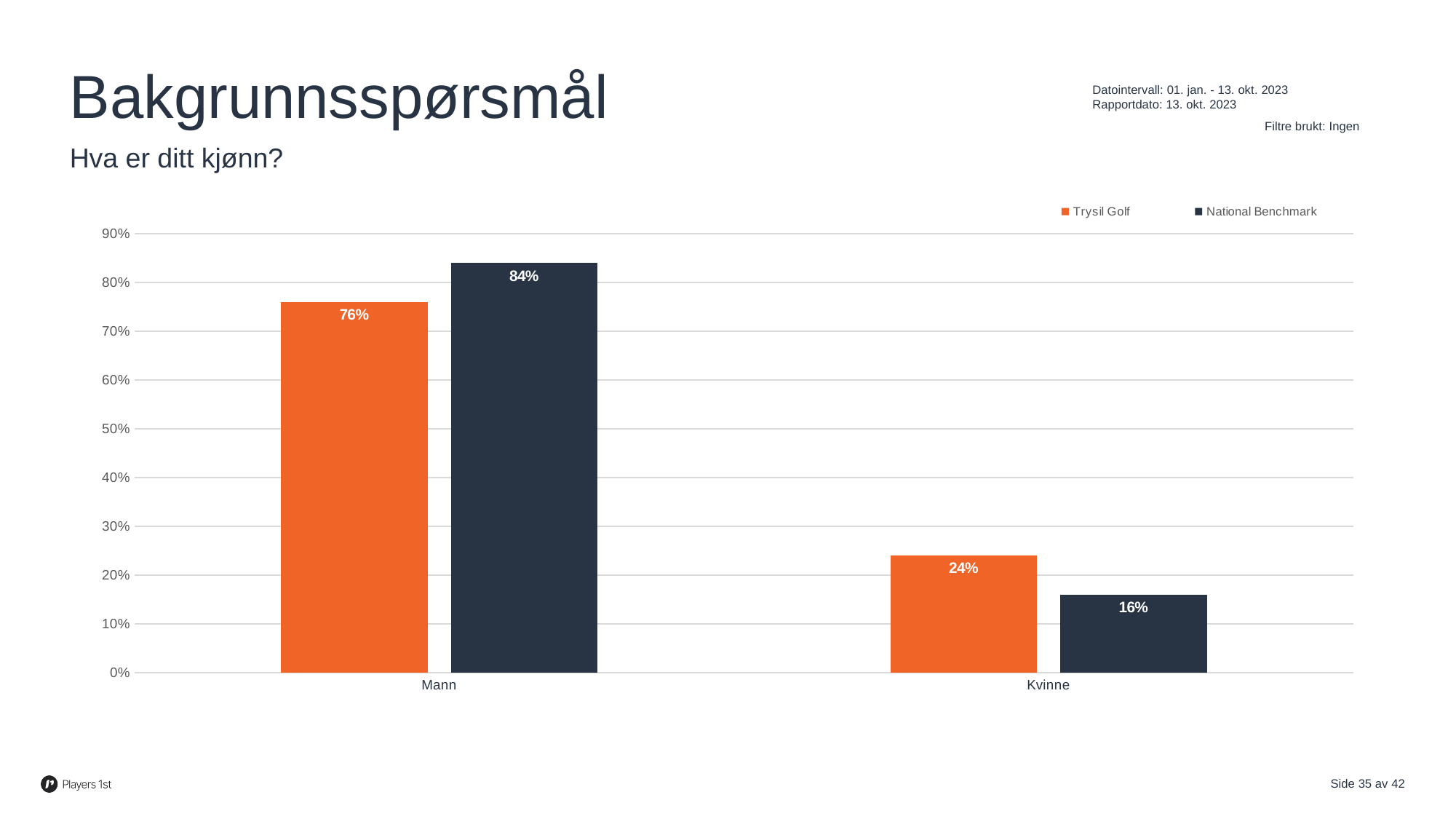
What is the value for National Benchmark in the Mann category? 84% How many categories are shown on the x axis? 2 What is the value for National Benchmark in the Kvinne category? 16% Which category has the highest value for the National Benchmark series? Mann What is the value for Trysil Golf in the Kvinne category? 24% What kind of chart is shown on the slide? Bar chart What is the value for Trysil Golf in the Mann category? 76% How many series does the legend list? 2 For Kvinne, which series has the larger value, Trysil Golf or National Benchmark? Trysil Golf What is the difference between the National Benchmark and Trysil Golf values for Mann? 8% Which category has the lowest value for the Trysil Golf series? Kvinne What is the difference between the Trysil Golf and National Benchmark values for Kvinne? 8%